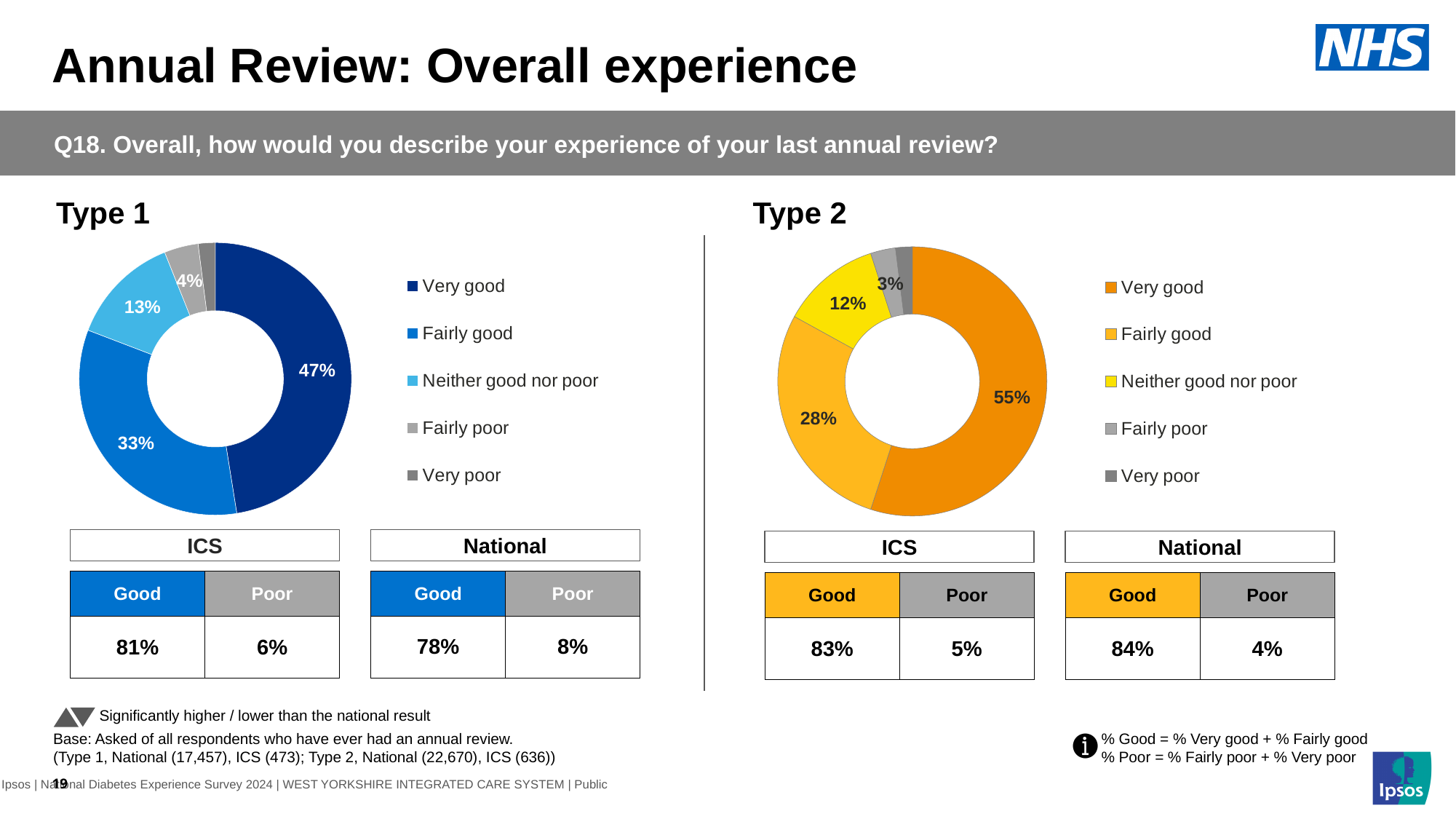
In the Type 2 chart, what share is shown for 'Fairly poor'? 3% In the Type 2 chart, what percentage of respondents said their experience was fairly good? 28% In the Type 1 chart, which labelled category has the smallest share? Fairly poor In the Type 1 chart, what percentage of respondents said their experience was very good? 47% How many categories does the legend of the Type 1 chart list? 5 In the Type 2 chart, which category has the largest share? Very good In the Type 1 chart, what is the difference between the 'Very good' and 'Fairly good' shares? 14 percentage points In the Type 1 chart, what is the combined share of 'Very good' and 'Fairly good'? 80% In the Type 1 chart, what share is shown for 'Neither good nor poor'? 13% What kind of chart is used for Type 2? Donut (pie) chart Which is larger: the 'Very good' share in the Type 1 chart or the 'Very good' share in the Type 2 chart? Type 2 In the Type 2 chart, what colour represents 'Neither good nor poor'? Yellow